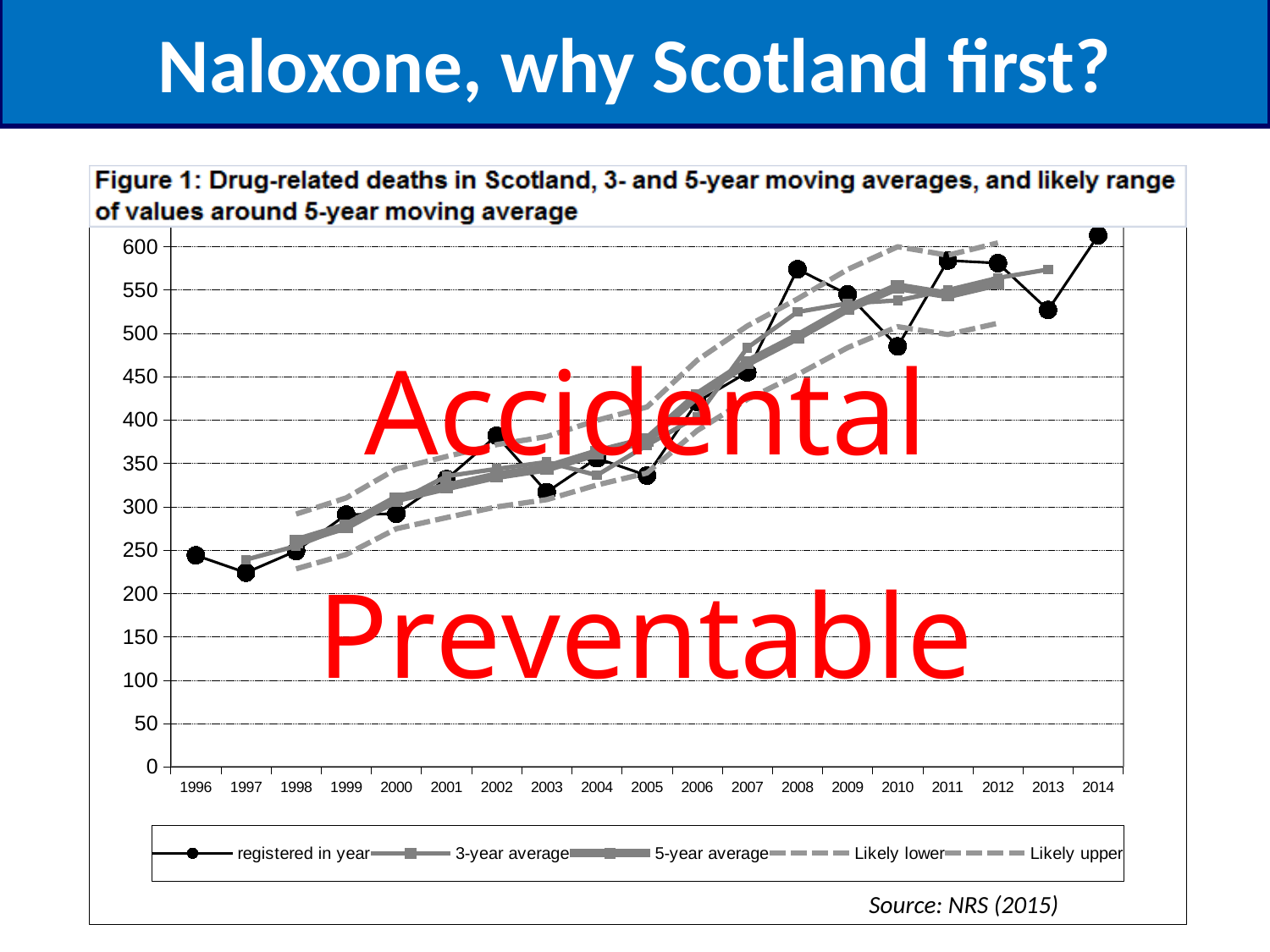
What kind of chart is shown on the slide? line chart Is the 'registered in year' value for 2010 greater or less than 500? less Is the 'registered in year' value for 2014 greater or less than 600? greater Is the 'registered in year' value for 2008 greater or less than 550? greater What source is cited for the chart? NRS (2015) Which year has the highest value for the 'registered in year' series? 2014 Overall, do the 'registered in year' values rise or fall from 1996 to 2014? rise Which year has the lowest value for the 'registered in year' series? 1997 How many years are shown on the x axis of the chart? 19 How many series does the chart legend list? 5 Which year has the larger 'registered in year' value, 2008 or 2010? 2008